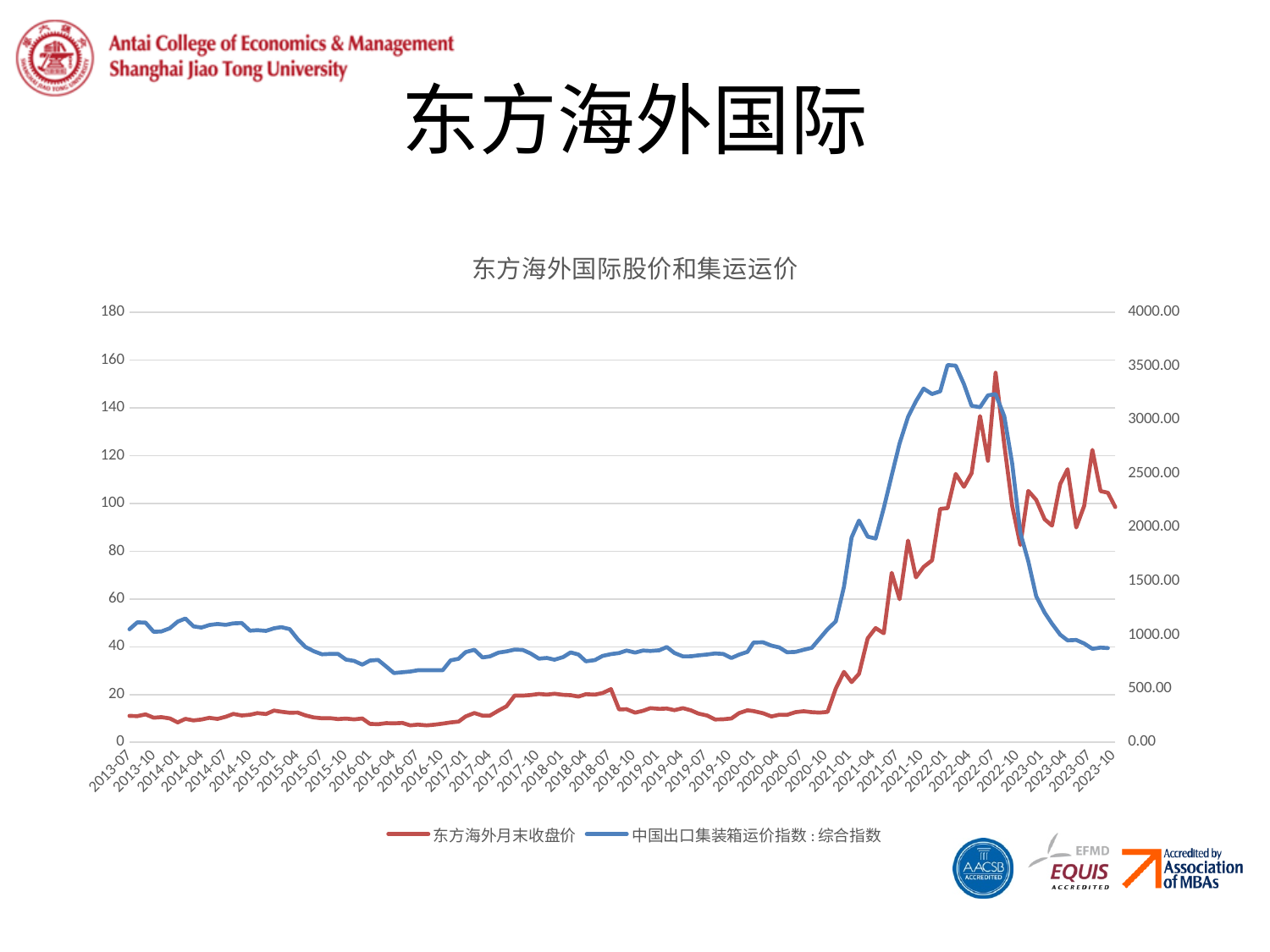
Is the value of 中国出口集装箱运价指数 : 综合指数 at 2022-01 greater or less than 3000.00 on the right axis? greater Which series is drawn in blue according to the legend? 中国出口集装箱运价指数 : 综合指数 Is 东方海外月末收盘价 larger at 2022-07 or at 2013-07? 2022-07 What is the title of the chart? 东方海外国际股价和集运运价 How many series does the chart legend list? 2 Is the value of 东方海外月末收盘价 at its 2022-07 peak greater or less than 140? greater Does 中国出口集装箱运价指数 : 综合指数 rise or fall between 2022-01 and 2023-10? fall Is the value of 东方海外月末收盘价 at 2013-07 greater or less than 20? less In which year does 东方海外月末收盘价 reach its highest point? 2022 Does 东方海外月末收盘价 rise or fall between 2020-10 and 2022-07? rise What kind of chart is shown on the slide? line chart